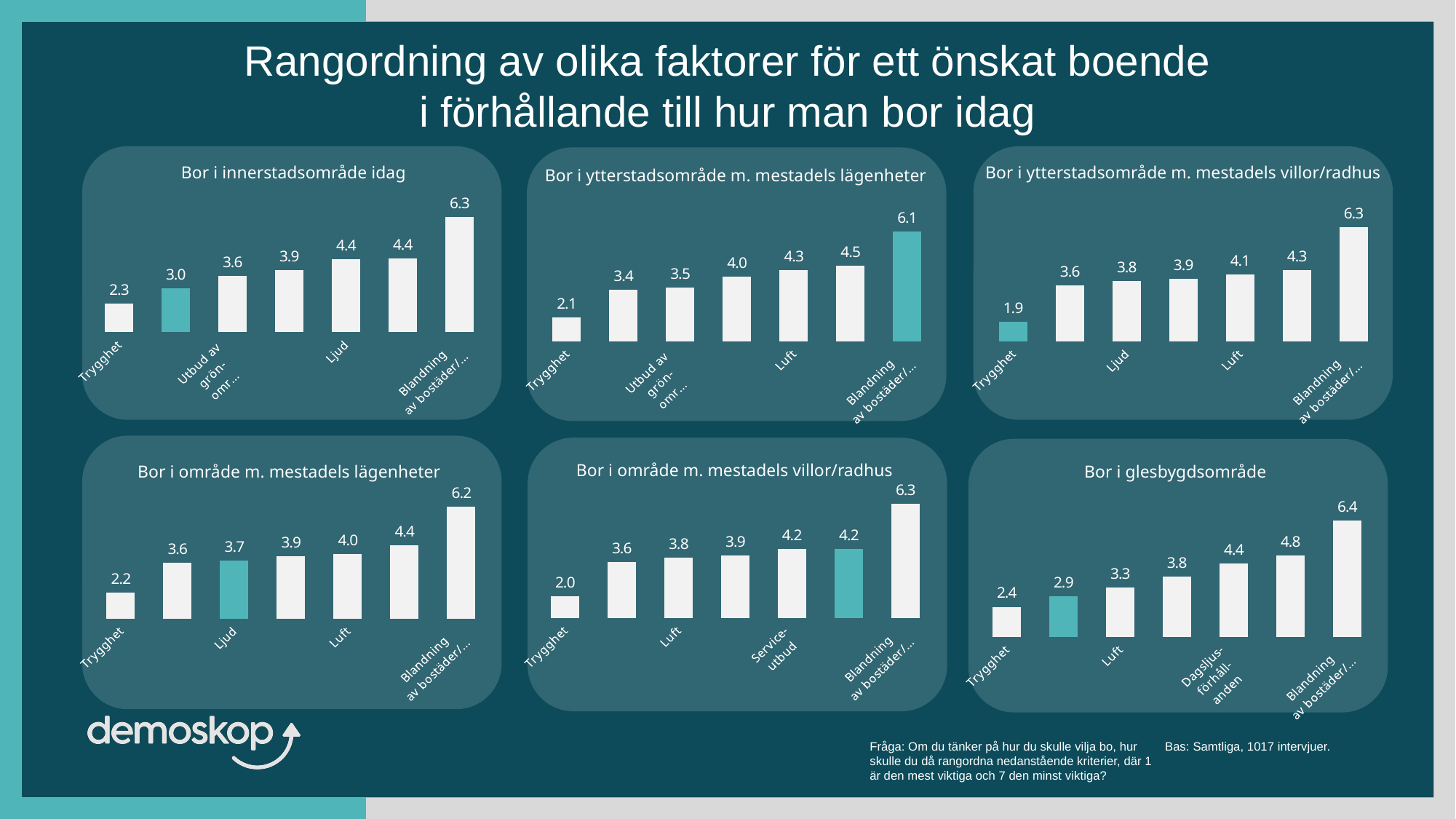
In the chart 'Bor i glesbygdsområde', what is the highest value shown? 6.4 What type of chart is used in 'Bor i innerstadsområde idag'? Bar chart In the chart 'Bor i område m. mestadels lägenheter', which is larger, the value for Luft or the value for Trygghet? Luft In the chart 'Bor i innerstadsområde idag', what is the value for Ljud? 4.4 In the chart 'Bor i ytterstadsområde m. mestadels villor/radhus', which category has the lowest value? Trygghet In the chart 'Bor i glesbygdsområde', what is the value for Dagsljus-förhållanden? 4.4 How many bars does the chart 'Bor i glesbygdsområde' contain? 7 In the chart 'Bor i ytterstadsområde m. mestadels lägenheter', what is the value for Luft? 4.3 In the chart 'Bor i innerstadsområde idag', what is the value for Trygghet? 2.3 In the chart 'Bor i område m. mestadels lägenheter', what is the value for Ljud? 3.7 In the chart 'Bor i område m. mestadels villor/radhus', what is the value for Service-utbud? 4.2 In the chart 'Bor i ytterstadsområde m. mestadels villor/radhus', what is the difference between the highest value (6.3) and the value for Trygghet (1.9)? 4.4